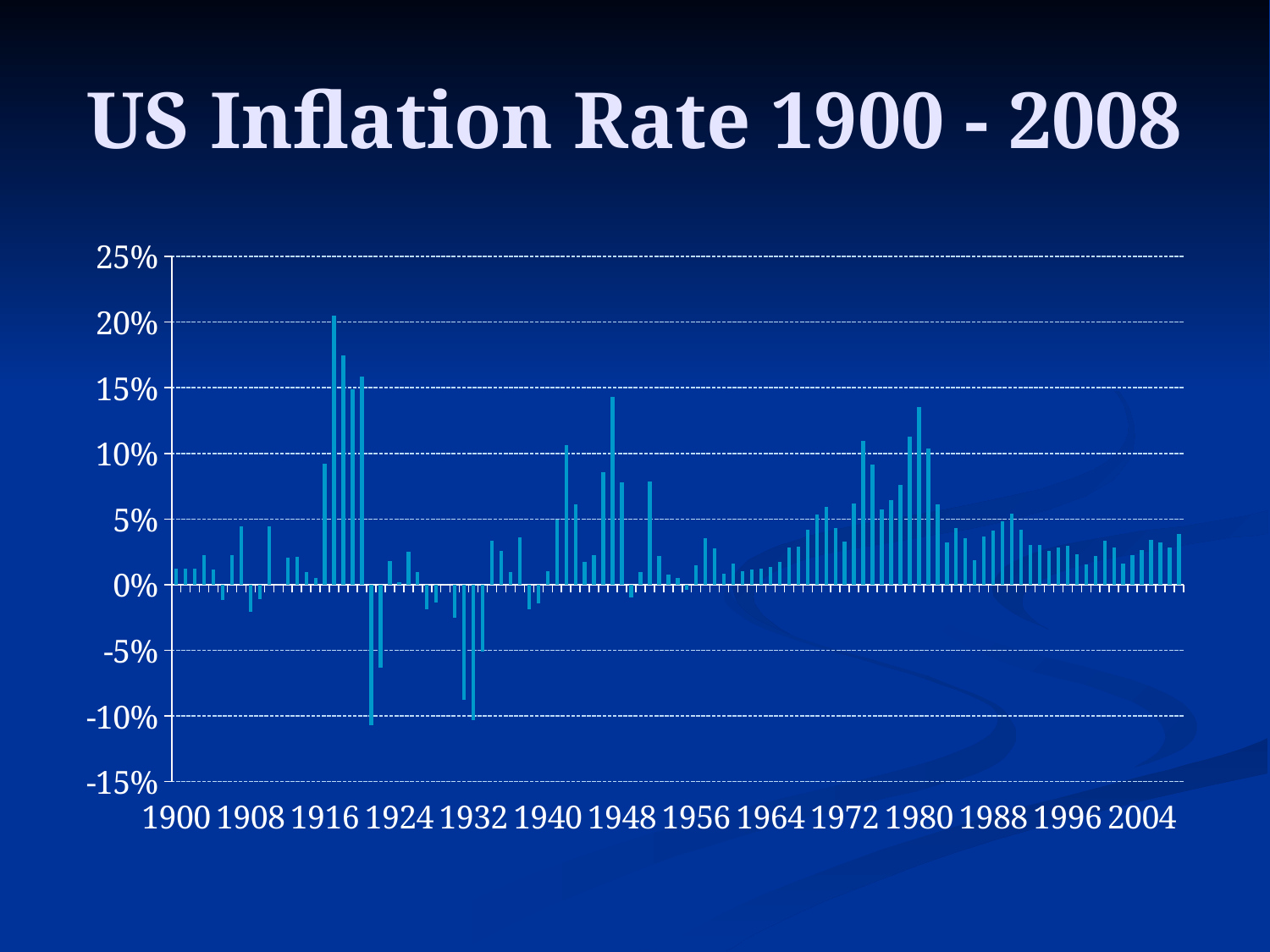
Is the value for 1900 greater or less than 5%? less Which year has the larger value, 1980 or 2004? 1980 Is the value for 1932 greater or less than -5%? less Between 1980 and 1988, do the values generally rise or fall? fall Is the value for 1948 greater or less than 5%? greater What is the highest value shown on the vertical axis? 25% What kind of chart is shown on the slide? bar chart What is the title of the chart? US Inflation Rate 1900 - 2008